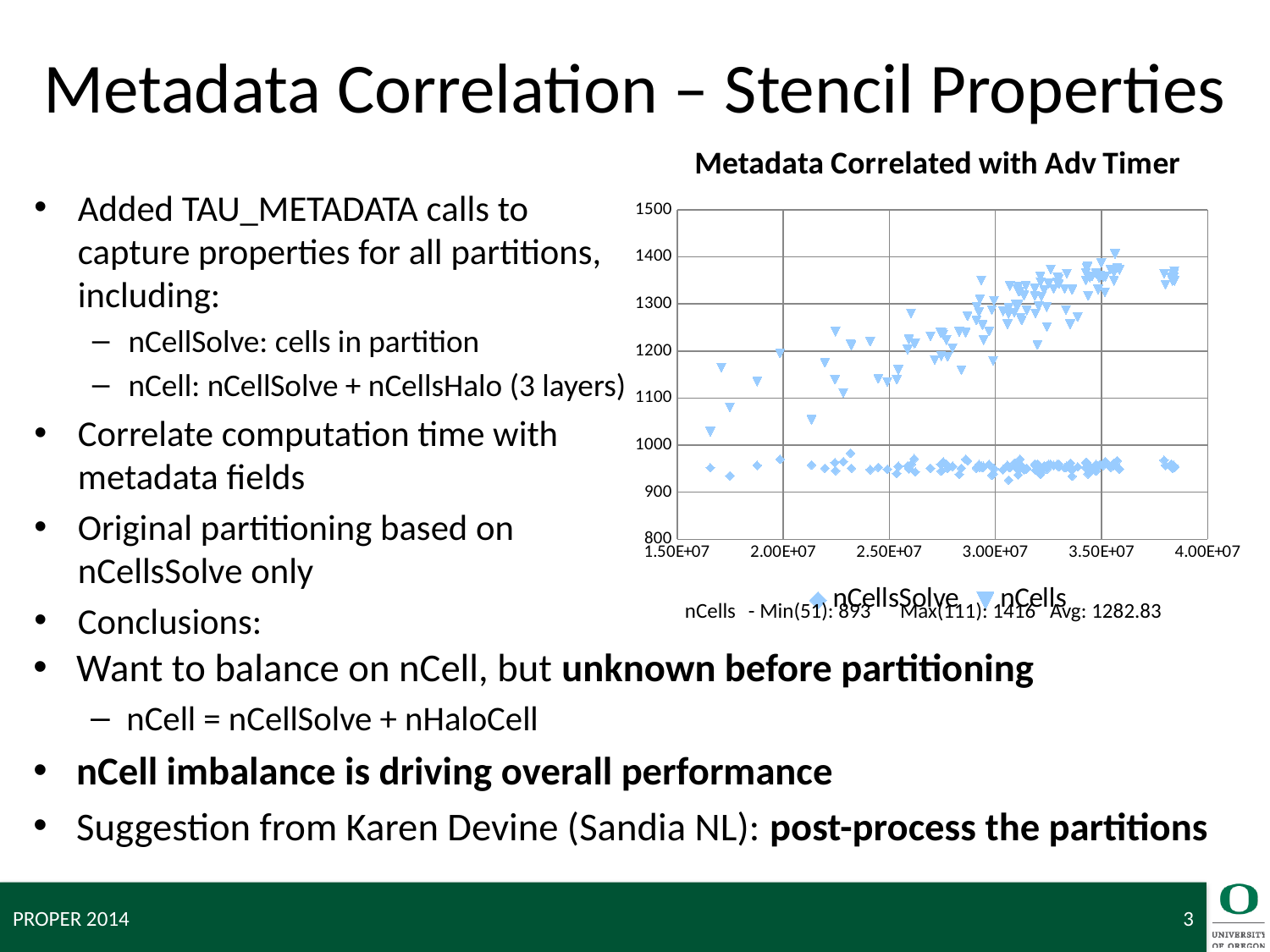
How many series does the chart's legend list? 2 Are the nCells values near x = 3.50E+07 greater or less than 1300? greater What are the two series named in the chart legend? nCellsSolve and nCells What is the title of the chart? Metadata Correlated with Adv Timer Are the nCellsSolve values greater or less than 1000? less Are the nCells values near x = 2.00E+07 greater or less than 1300? less According to the text printed below the chart, what is the maximum nCells value? 1416 According to the text printed below the chart, what is the average nCells value? 1282.83 Which series has the higher values overall, nCellsSolve or nCells? nCells Which series reaches the highest value on the chart? nCells What kind of chart is shown on the slide? scatter chart Do the nCells values rise or fall as the x-axis value increases? rise